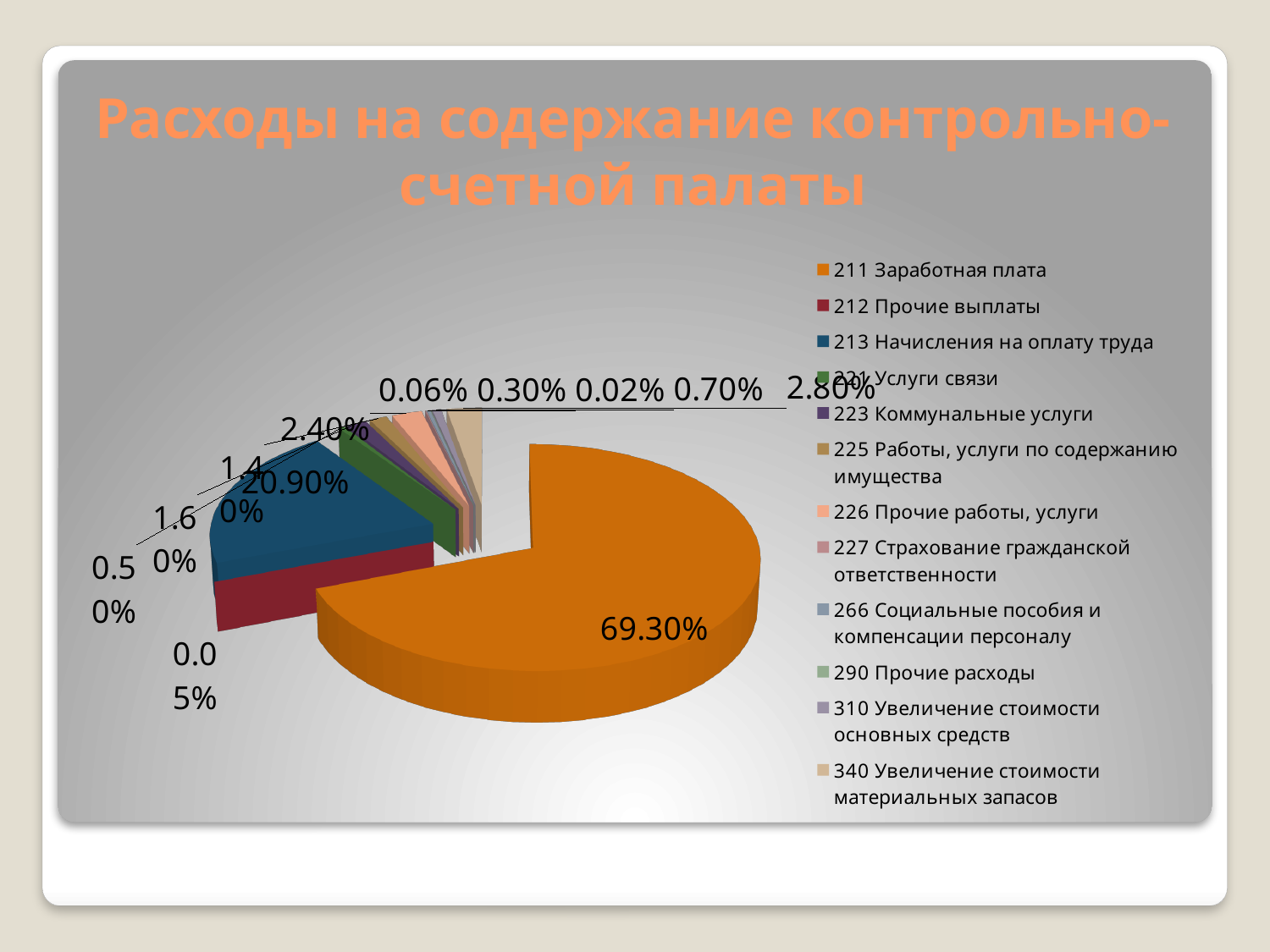
What is the title of the chart on the slide? Расходы на содержание контрольно-счетной палаты How many slices does the pie chart have? 12 Which is larger: the slice for 211 Заработная плата or the slice for 213 Начисления на оплату труда? 211 Заработная плата What is the difference between the 211 Заработная плата slice (69.30%) and the 213 Начисления на оплату труда slice (20.90%)? 48.40% What colour is the slice for 211 Заработная плата? orange What value is labelled on the slice for 213 Начисления на оплату труда? 20.90% What kind of chart is shown on the slide? pie chart How many entries does the legend of the pie chart list? 12 What is the smallest percentage label shown on the pie chart? 0.02% Which category has the largest slice of the pie? 211 Заработная плата What share of the pie does 211 Заработная плата take? 69.30%